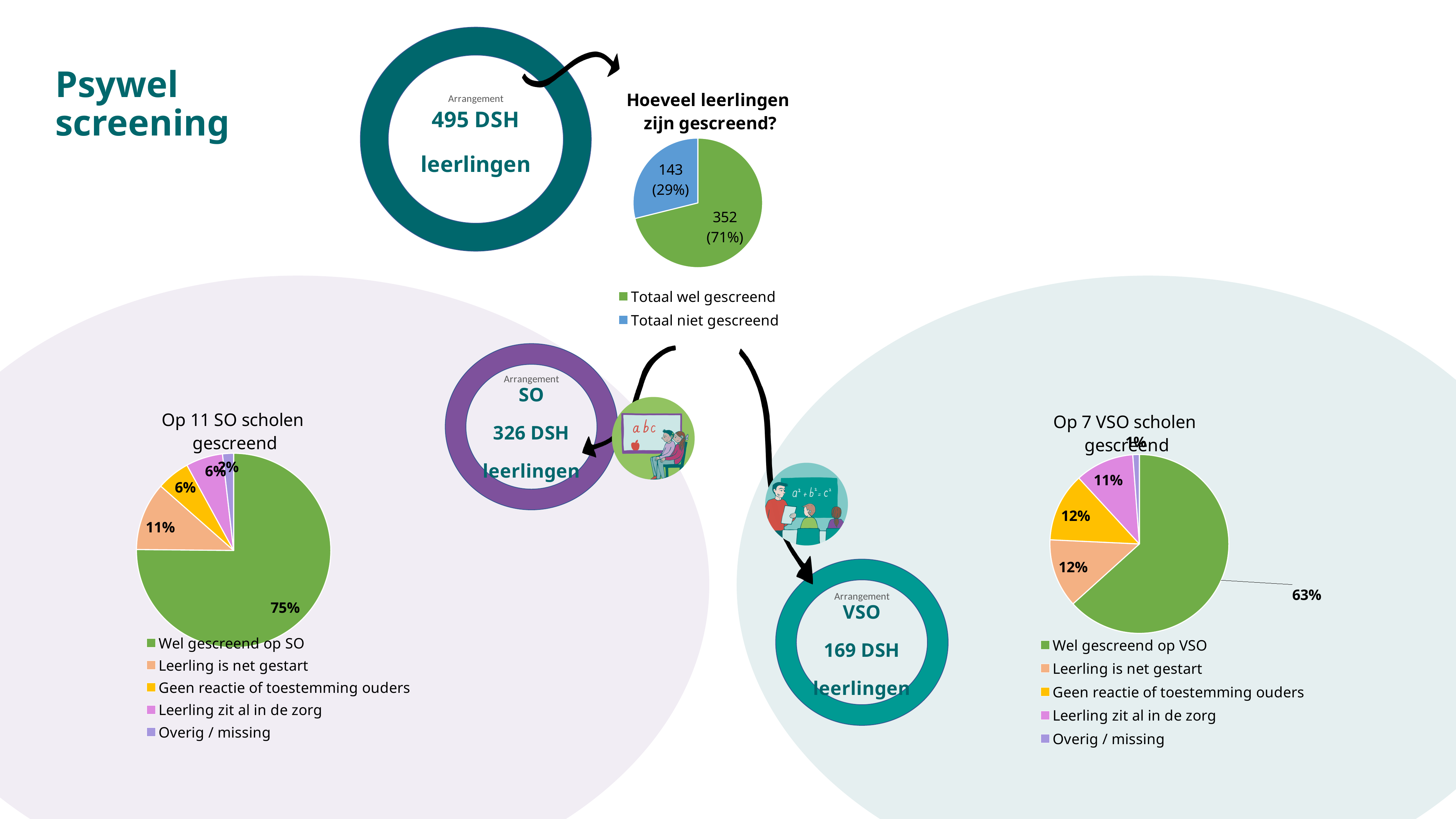
In the chart titled 'Hoeveel leerlingen zijn gescreend?', what is the difference between the number of students screened and not screened? 209 In the chart titled 'Op 11 SO scholen gescreend', what share is 'Wel gescreend op SO'? 75% In the chart titled 'Hoeveel leerlingen zijn gescreend?', how many students were screened (Totaal wel gescreend)? 352 (71%) In the chart titled 'Op 7 VSO scholen gescreend', what share is 'Leerling zit al in de zorg'? 11% How many categories does the legend of the chart 'Op 11 SO scholen gescreend' list? 5 In the chart titled 'Op 7 VSO scholen gescreend', which colour represents 'Geen reactie of toestemming ouders'? Yellow Which is larger: the 'Wel gescreend' share in the SO chart or in the VSO chart? SO chart (75%) In the chart titled 'Op 11 SO scholen gescreend', what share is 'Leerling is net gestart'? 11% What kind of chart is used for 'Hoeveel leerlingen zijn gescreend?'? Pie chart In the chart titled 'Op 11 SO scholen gescreend', which category has the smallest slice? Overig / missing